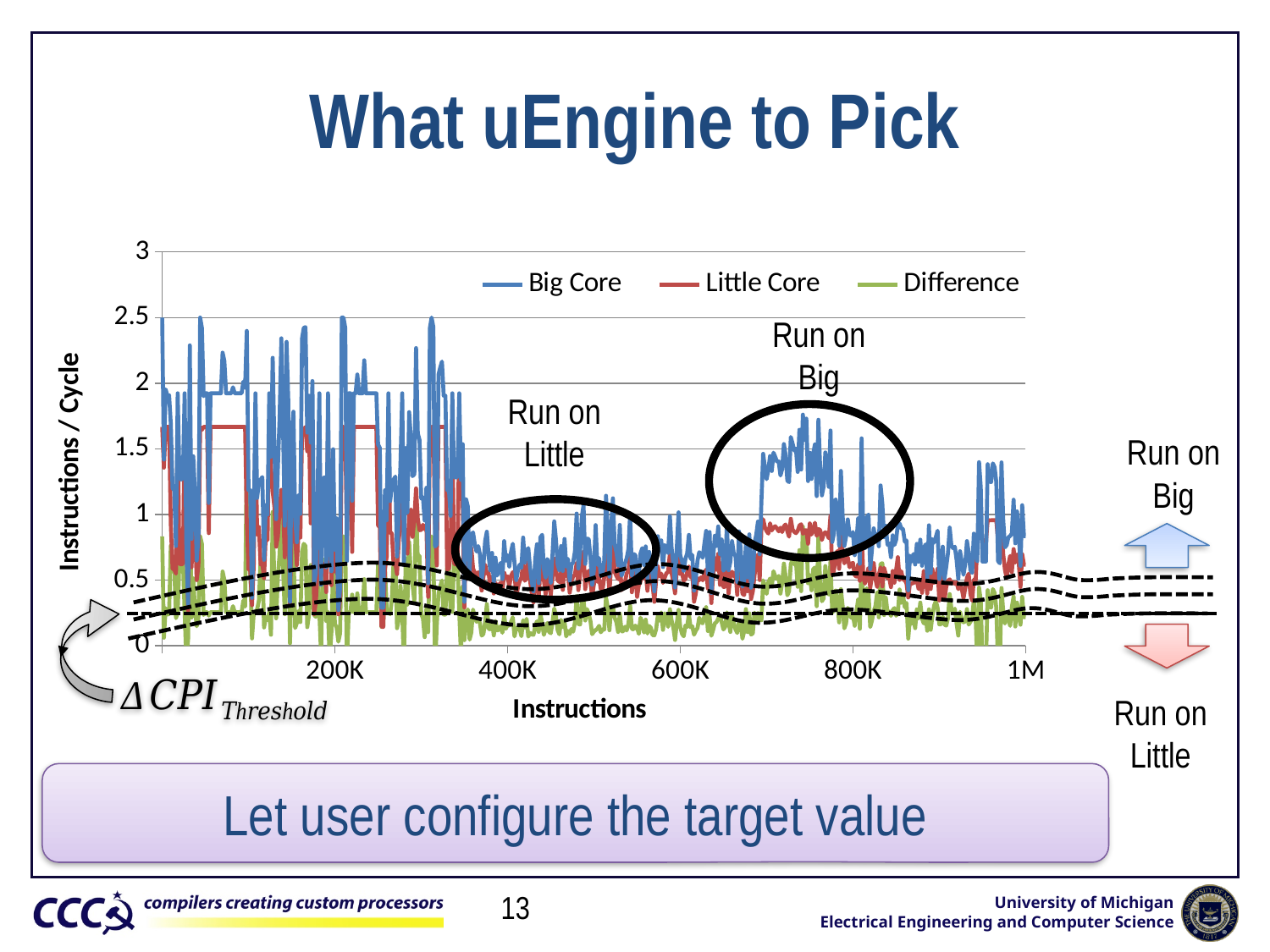
What is the title of the y axis of the chart? Instructions / Cycle Which series reaches the highest value anywhere on the chart? Big Core How many series does the chart legend list? 3 Is the Big Core value at around 750K instructions greater or less than 1? greater What is the last tick label shown on the x axis of the chart? 1M What are the three series named in the chart legend? Big Core, Little Core, Difference Does the Big Core series generally rise or fall between 200K and 400K instructions? fall What is the highest tick value shown on the y axis of the chart? 3 What kind of chart is shown on the slide? line chart Around 750K instructions, which series has the larger value, Big Core or Little Core? Big Core Is the Difference series value at around 900K instructions greater or less than 1? less Is the Little Core value at around 750K instructions greater or less than 1? less